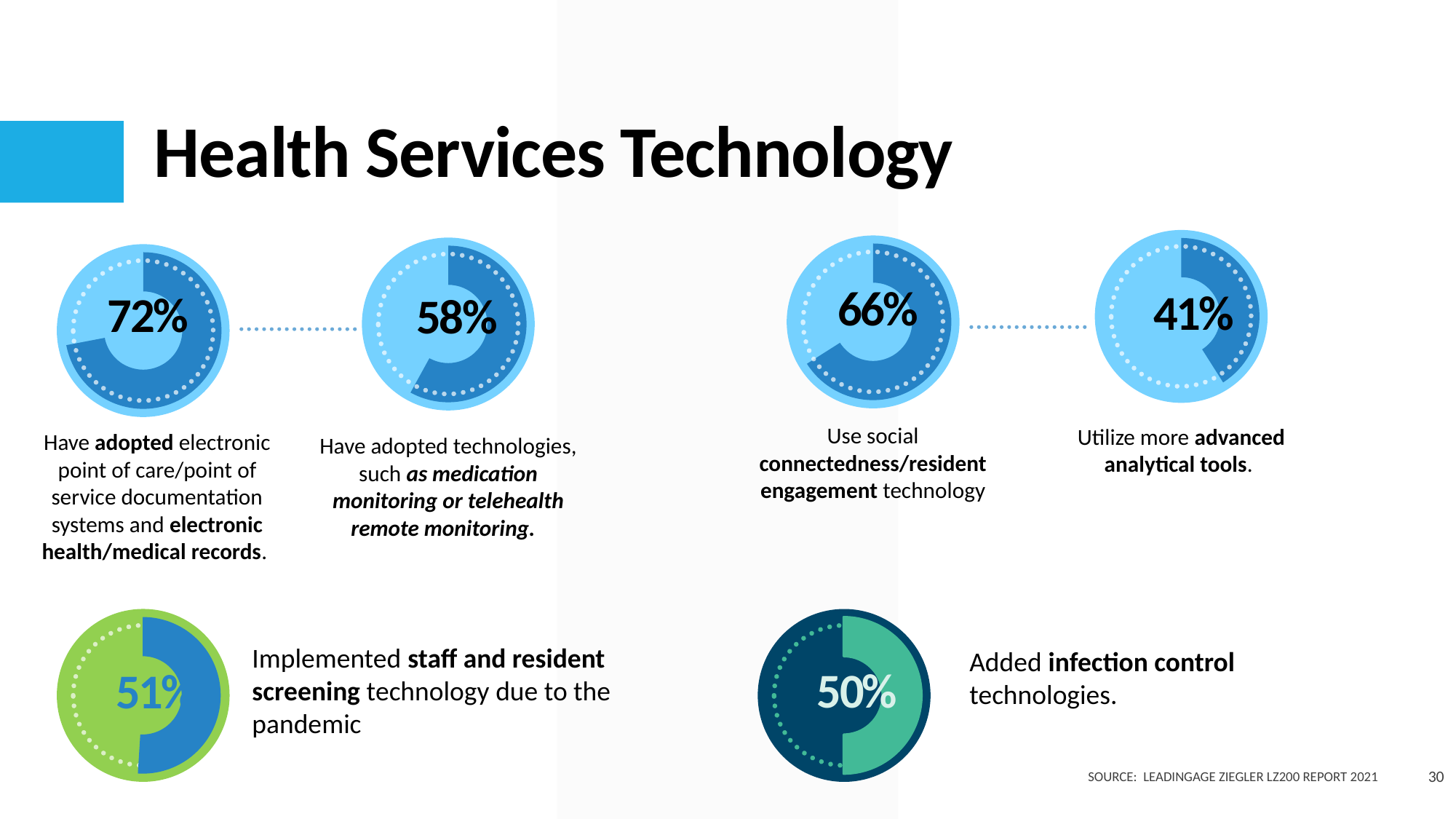
What percentage added infection control technologies? 50% How many donut charts are shown on the slide? 6 What colour is the outer ring of the donut chart showing 51%? Green Which is larger: the percentage that implemented staff and resident screening technology or the percentage that added infection control technologies? Staff and resident screening technology (51%) What is the difference in percentage points between those who use social connectedness/resident engagement technology and those who utilize more advanced analytical tools? 25 percentage points What percentage implemented staff and resident screening technology due to the pandemic? 51% What percentage use social connectedness/resident engagement technology? 66% Which technology category on the slide has the highest percentage? Adopted electronic point of care/point of service documentation systems and electronic health/medical records (72%) What percentage utilize more advanced analytical tools? 41% What percentage have adopted electronic point of care/point of service documentation systems and electronic health/medical records? 72% What percentage have adopted technologies such as medication monitoring or telehealth remote monitoring? 58% Which technology category on the slide has the lowest percentage? Utilize more advanced analytical tools (41%)